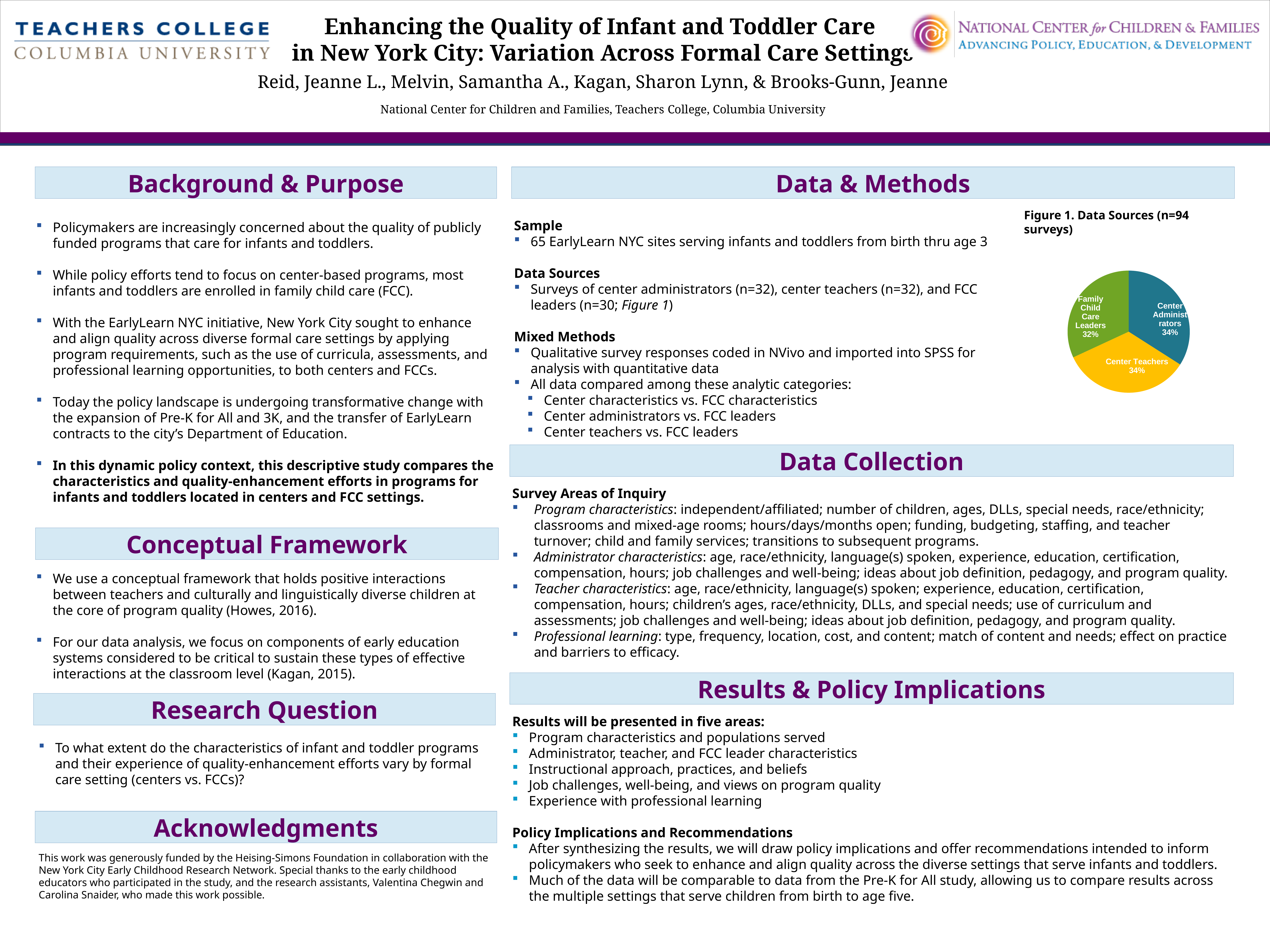
What share of the pie chart is Family Child Care Leaders? 32% What share of the pie chart is Center Administrators? 34% What kind of chart is Figure 1? pie chart What is the difference in percentage points between Center Administrators and Family Child Care Leaders in the pie chart? 2% How many surveys does the pie chart title say the data sources total? 94 Is the share for Family Child Care Leaders in the pie chart greater or less than 34%? less Which slice of the pie chart is the smallest? Family Child Care Leaders How many slices does the pie chart have? 3 What share of the pie chart is Center Teachers? 34% What is the title of the pie chart? Figure 1. Data Sources (n=94 surveys) Which is larger in the pie chart, Center Teachers or Family Child Care Leaders? Center Teachers